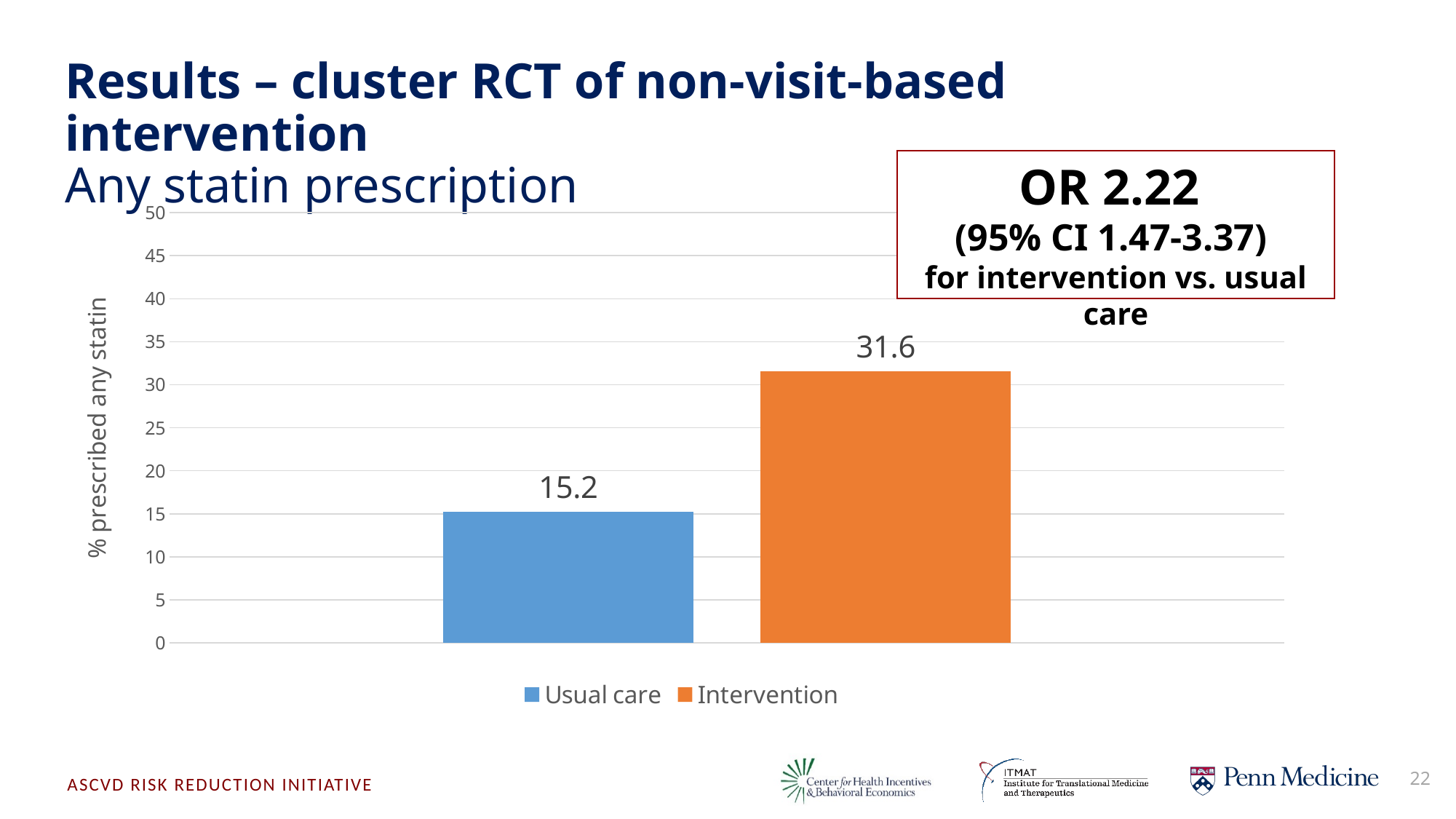
What is the label of the vertical axis? % prescribed any statin Is the value for Usual care larger or smaller than the value for Intervention? smaller What is the value for Intervention? 31.6 What kind of chart is shown on the slide? bar chart What is the difference between the Intervention and Usual care values? 16.4 Which group has the lower percentage prescribed any statin? Usual care How many series does the legend list? 2 Which group has the higher percentage prescribed any statin? Intervention What is the value for Usual care? 15.2 Is the value for Usual care greater or less than 20? less How many bars are plotted in the chart? 2 Is the value for Intervention greater or less than 30? greater